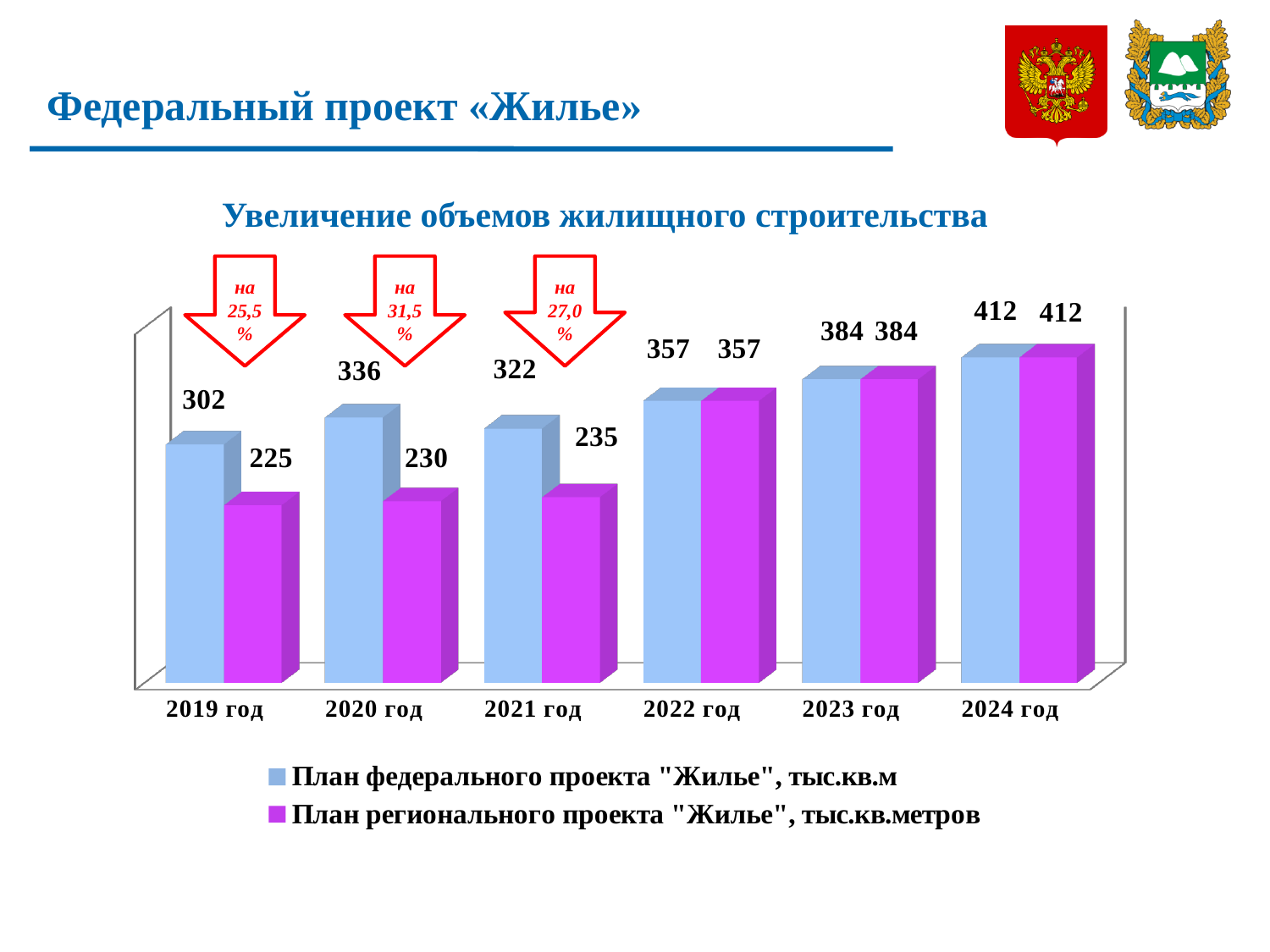
What is the difference between the federal plan and the regional plan in 2020 год? 106 Which is larger in 2019 год: the federal project plan or the regional project plan? План федерального проекта "Жилье" What is the value of the regional project plan (План регионального проекта "Жилье") for 2021 год? 235 What is the value of the federal project plan for 2023 год? 384 How many years are shown on the x axis of the chart? 6 How many series does the legend list? 2 What is the value of the federal project plan (План федерального проекта "Жилье") for 2019 год? 302 What is the title of the chart? Увеличение объемов жилищного строительства What kind of chart is shown on the slide? Bar chart Does the regional project plan value rise or fall from 2019 год to 2024 год? Rise In which year is the federal project plan value the highest? 2024 год In which year is the regional project plan value the lowest? 2019 год